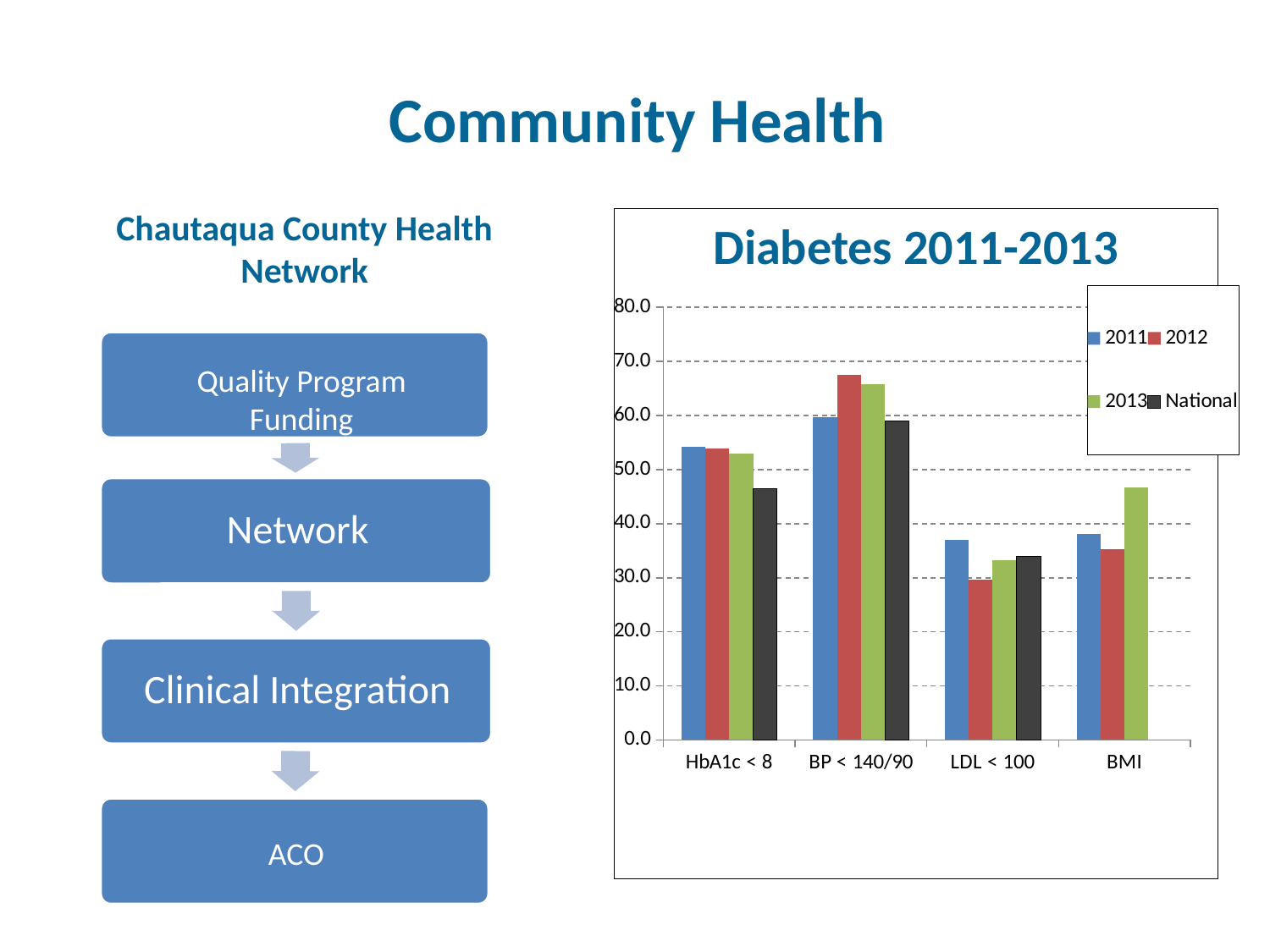
How many categories are shown on the x axis of the chart? 4 Which category has the lowest 2012 value? LDL < 100 For BMI, which series has the larger value, 2013 or 2012? 2013 Is the National value for HbA1c < 8 greater or less than 50? less How many series does the chart legend list? 4 Which category has no National bar plotted? BMI Is the 2012 value for BP < 140/90 greater or less than 60? greater What is the title of the chart? Diabetes 2011-2013 Which category has the highest 2012 value? BP < 140/90 What type of chart is shown on the slide? bar chart For LDL < 100, which series has the larger value, 2011 or 2012? 2011